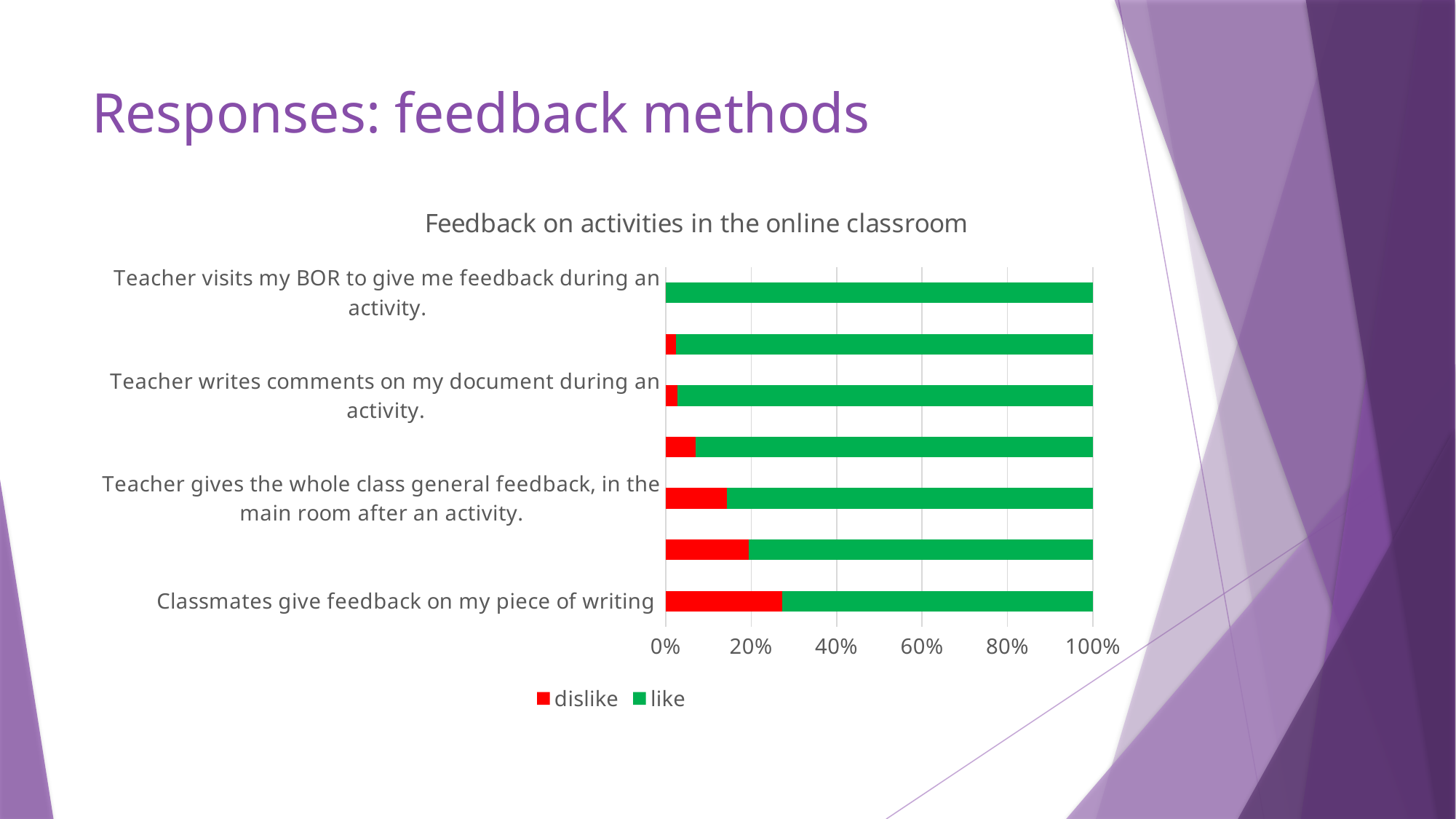
What is the title of the chart? Feedback on activities in the online classroom How many series does the legend list? 2 Is the 'like' value for 'Classmates give feedback on my piece of writing' greater or less than 60%? greater Is the 'dislike' value for 'Teacher gives the whole class general feedback, in the main room after an activity.' greater or less than 20%? less Is the 'dislike' value for 'Classmates give feedback on my piece of writing' greater or less than 20%? greater Among the labelled categories, which has the smallest 'dislike' share? Teacher visits my BOR to give me feedback during an activity. Which has a larger 'dislike' share: 'Classmates give feedback on my piece of writing' or 'Teacher gives the whole class general feedback, in the main room after an activity.'? Classmates give feedback on my piece of writing How many bars are plotted in the chart? 7 Among the labelled categories, which has the largest 'dislike' share? Classmates give feedback on my piece of writing What type of chart is shown on the slide? bar chart Which series is shown in red in the chart? dislike